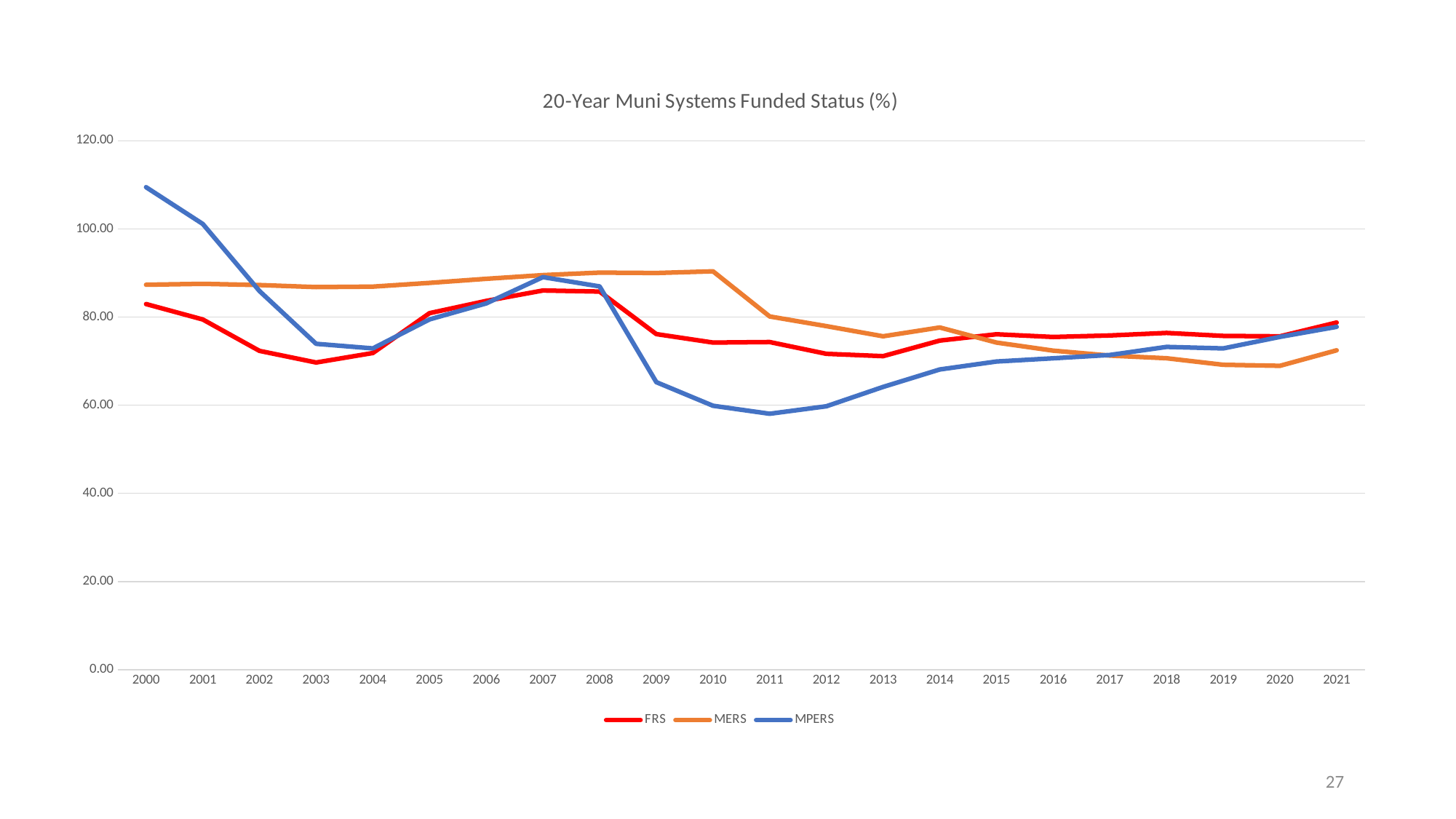
In 2010, which is larger, MERS or MPERS? MERS What is the title of the chart? 20-Year Muni Systems Funded Status (%) Which series is drawn in blue? MPERS Is the value for MPERS in 2011 greater or less than 60? less Does the MPERS line rise or fall from 2000 to 2003? Fall Which series has the highest value in 2000? MPERS In which year does MPERS reach its lowest value? 2011 How many years are plotted along the x axis? 22 What kind of chart is shown on the slide? Line chart Is the value for MPERS in 2000 greater or less than 100? greater Is the value for FRS in 2003 greater or less than 80? less How many series does the legend list? 3